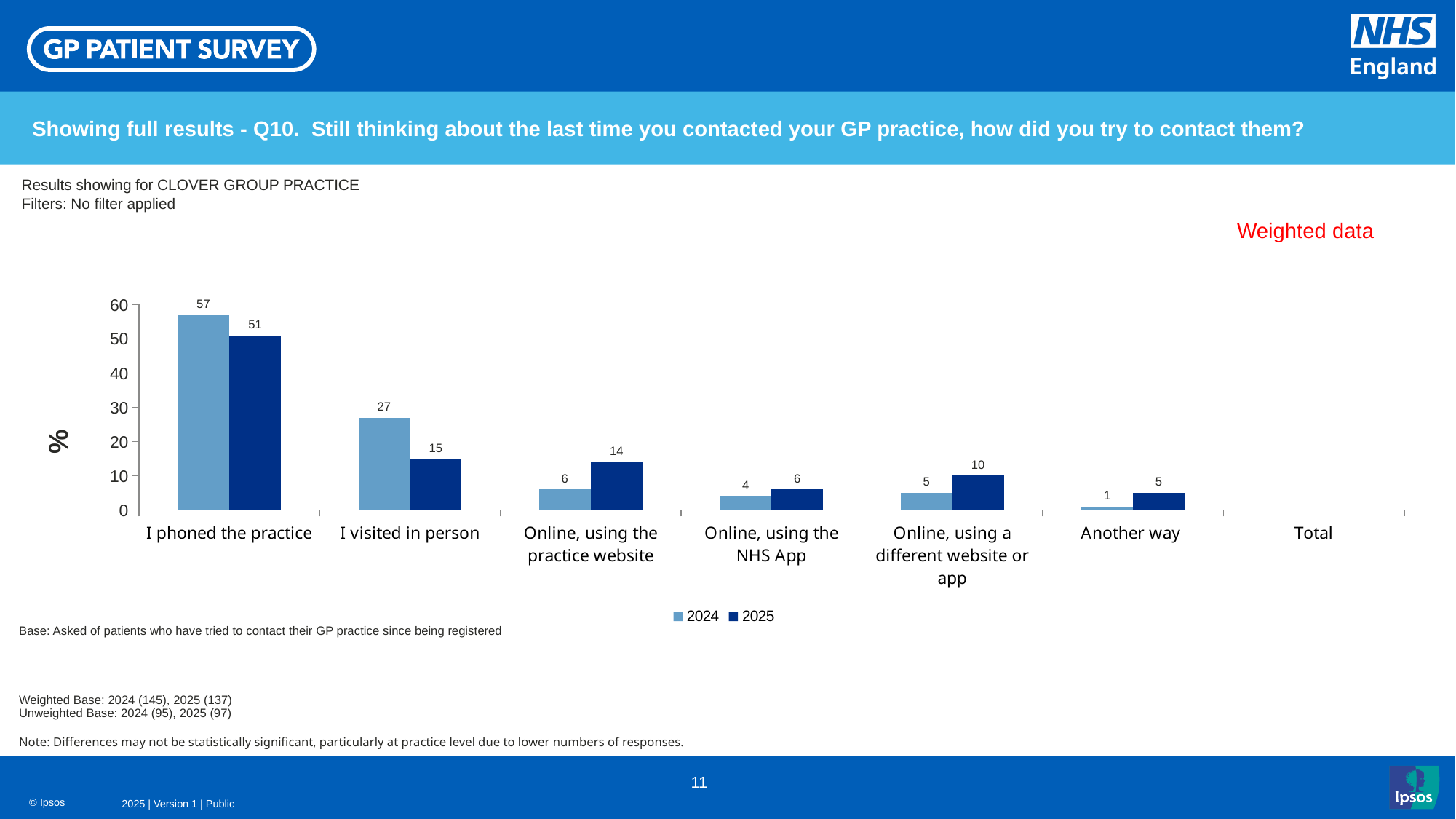
What kind of chart is shown on the slide? Bar chart What is the 2025 value for 'I visited in person'? 15 Which is larger for 'Online, using a different website or app': the 2024 value or the 2025 value? 2025 Which category has the lowest 2024 value? Another way Which category has the highest 2025 value? I phoned the practice What is the 2024 value for 'Another way'? 1 What is the difference between the 2024 and 2025 values for 'I visited in person'? 12 What label is shown on the vertical axis of the chart? % What is the 2025 value for 'Online, using the practice website'? 14 What is the 2024 value for 'I phoned the practice'? 57 How many series does the legend list? 2 Is the 2025 value for 'I phoned the practice' greater or less than 40? greater